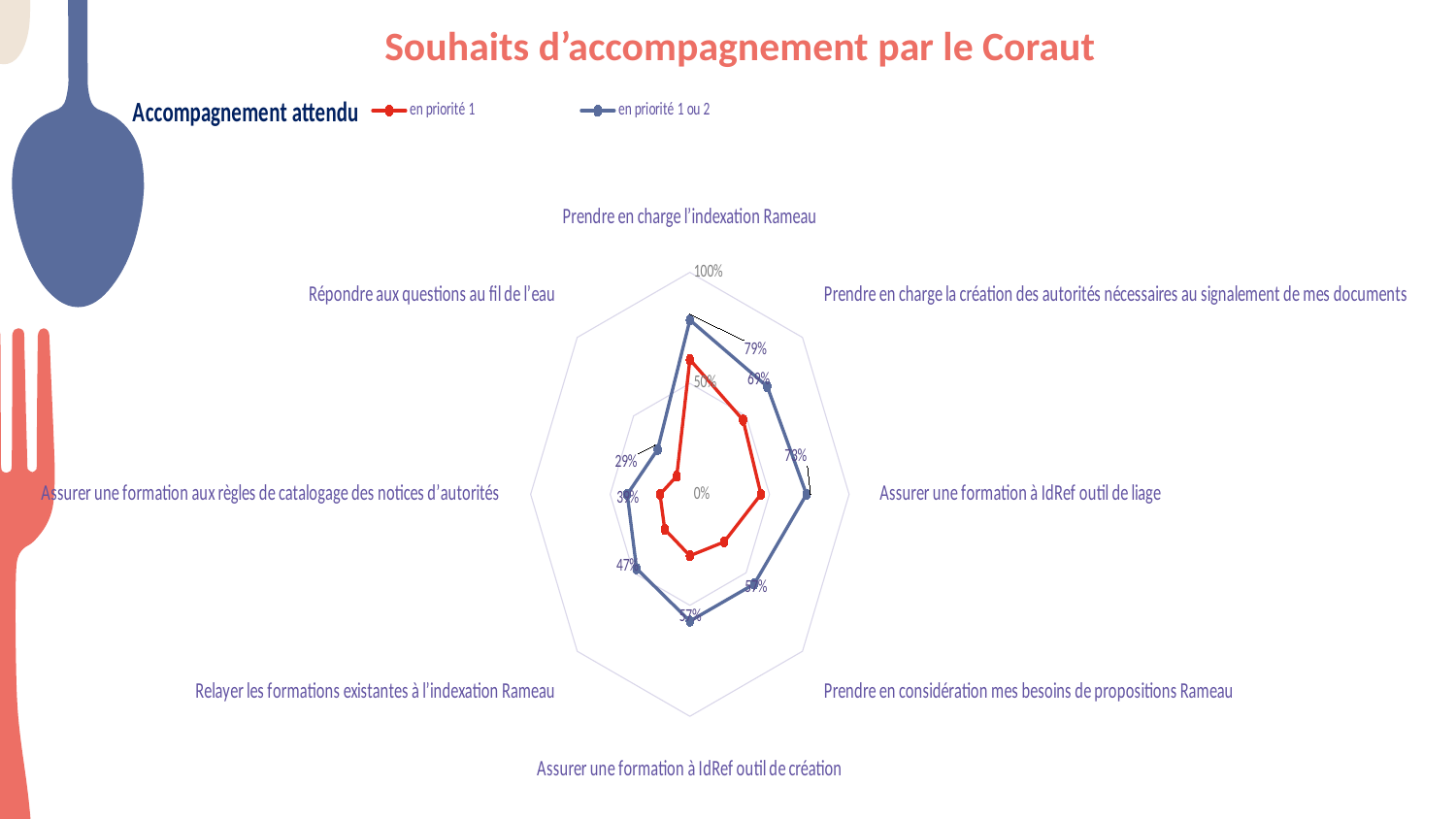
How many categories (axes) does the radar chart have? 8 Is the 'en priorité 1' value for 'Prendre en charge l'indexation Rameau' greater or less than 50%? greater What is the value of the 'en priorité 1 ou 2' series for 'Assurer une formation à IdRef outil de liage'? 73% What is the value of the 'en priorité 1 ou 2' series for 'Répondre aux questions au fil de l'eau'? 29% What is the value of the 'en priorité 1 ou 2' series for 'Relayer les formations existantes à l'indexation Rameau'? 47% How many series does the chart legend list? 2 Which series is drawn in red on the chart? en priorité 1 What kind of chart is shown on the slide? Radar chart For the 'en priorité 1 ou 2' series, which is larger: 'Prendre en charge l'indexation Rameau' or 'Assurer une formation à IdRef outil de création'? Prendre en charge l'indexation Rameau For the 'en priorité 1 ou 2' series, what is the difference between 'Prendre en charge l'indexation Rameau' (79%) and 'Relayer les formations existantes à l'indexation Rameau' (47%)? 32 percentage points What is the value of the 'en priorité 1 ou 2' series for 'Prendre en charge l'indexation Rameau'? 79% What is the value of the 'en priorité 1 ou 2' series for 'Assurer une formation à IdRef outil de création'? 57%